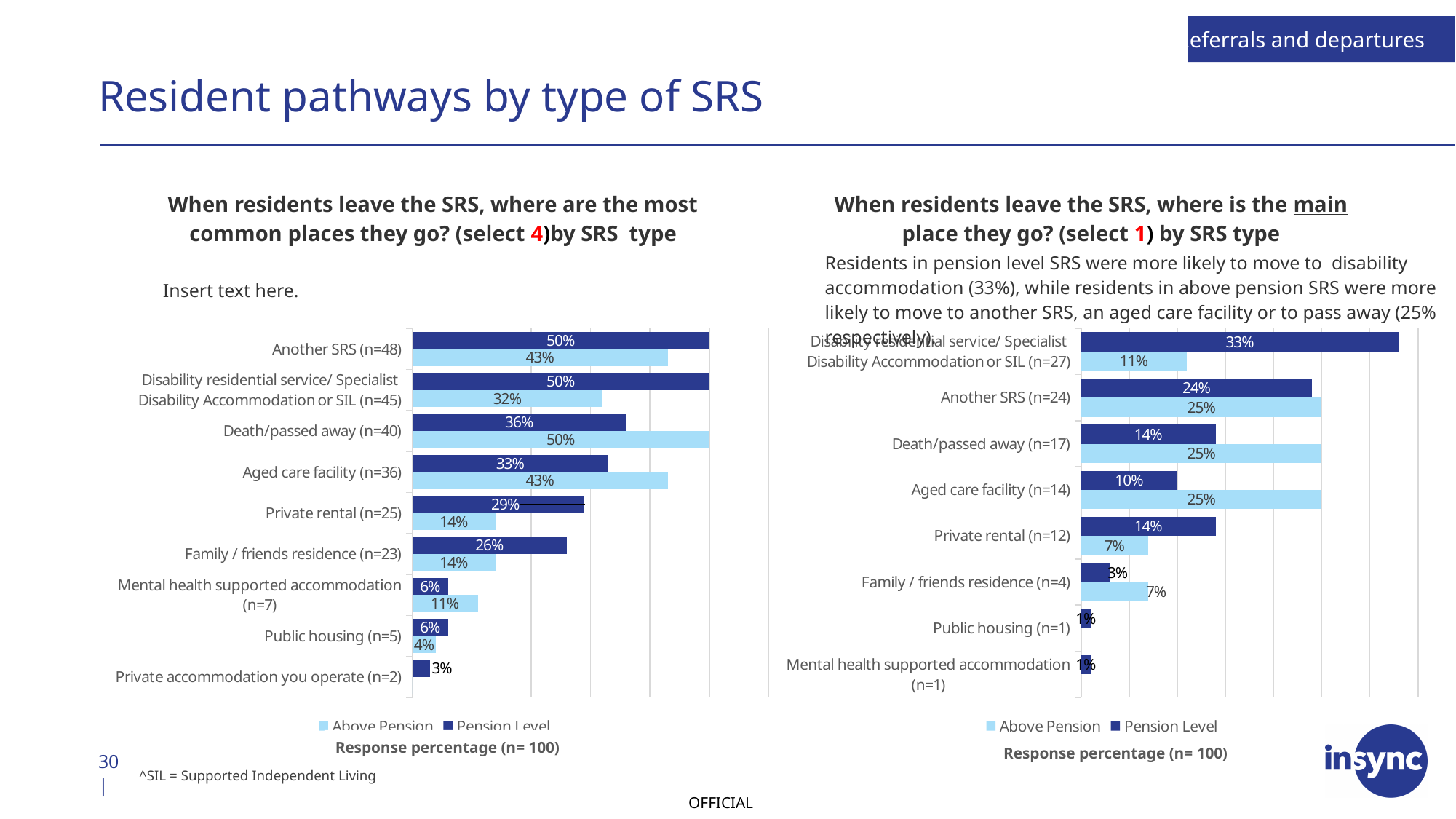
How many series does the legend of the right chart list? 2 In the right chart (select 1), what is the Pension Level value for Disability residential service/ Specialist Disability Accommodation or SIL? 33% In the left chart (select 4), what is the difference between the Pension Level and Above Pension values for Private rental? 15% In the left chart (select 4), how many categories are shown? 9 In the left chart (select 4), what is the Above Pension value for Death/passed away? 50% In the right chart (select 1), what is the difference between the Above Pension and Pension Level values for Death/passed away? 11% In the right chart (select 1), which category has the highest Pension Level value? Disability residential service/ Specialist Disability Accommodation or SIL (n=27) In the right chart (select 1), what is the Above Pension value for Aged care facility? 25% What type of chart is the left chart (select 4)? Bar chart In the left chart (select 4), which is larger for Aged care facility: the Above Pension value or the Pension Level value? Above Pension In the left chart (select 4), what is the Pension Level value for Another SRS? 50%